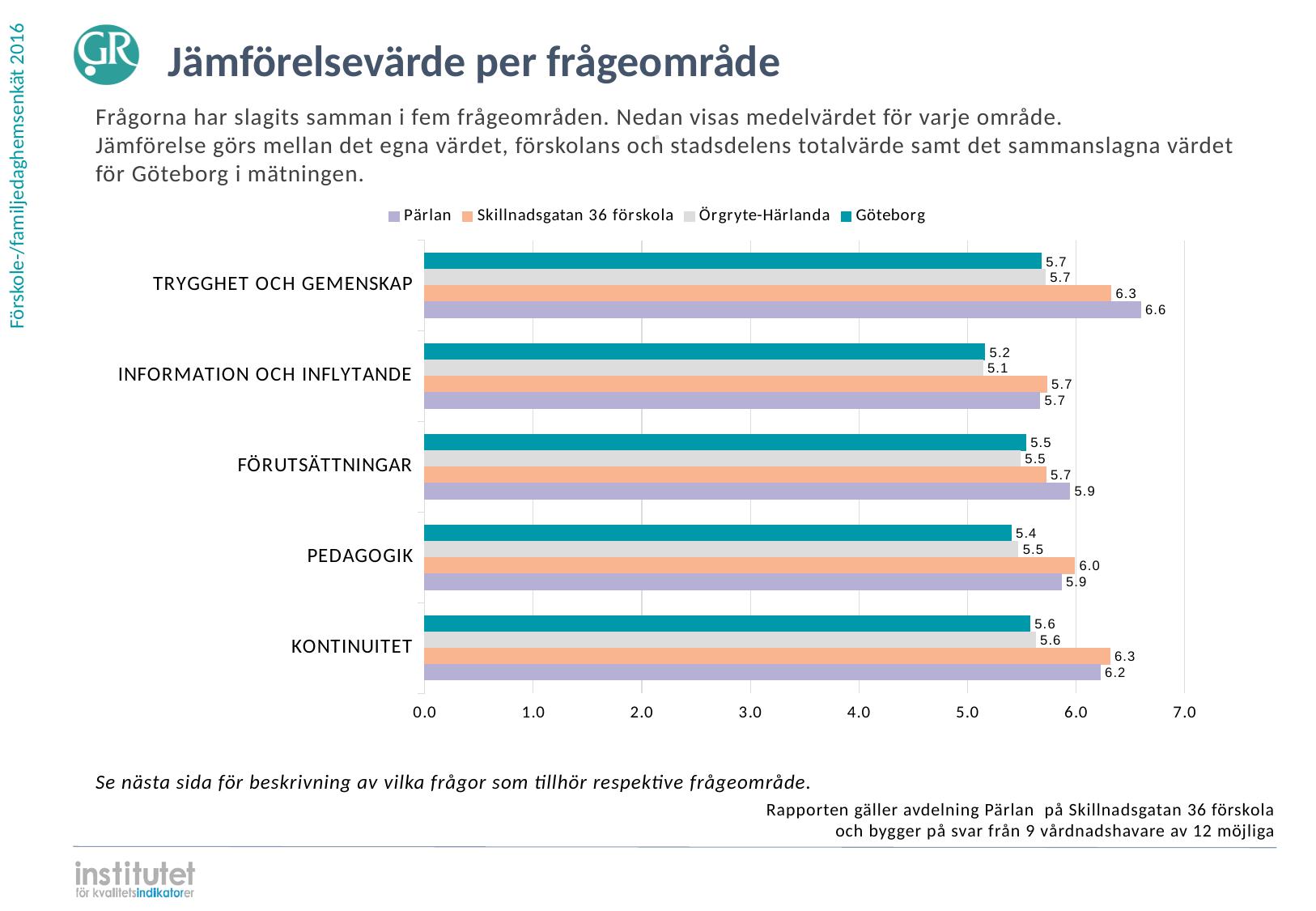
What is the value for Pärlan in TRYGGHET OCH GEMENSKAP? 6.6 What kind of chart is shown on the slide? bar chart What is the value for Skillnadsgatan 36 förskola in PEDAGOGIK? 6.0 What is the value for Göteborg in INFORMATION OCH INFLYTANDE? 5.2 What is the difference between Pärlan and Göteborg in TRYGGHET OCH GEMENSKAP? 0.9 In FÖRUTSÄTTNINGAR, which is larger: Pärlan or Skillnadsgatan 36 förskola? Pärlan In which category does Göteborg have its lowest value? INFORMATION OCH INFLYTANDE What is the value for Örgryte-Härlanda in KONTINUITET? 5.6 How many series does the legend list? 4 How many question areas (categories) are shown on the chart? 5 In which category does Pärlan have its highest value? TRYGGHET OCH GEMENSKAP Which series is shown in orange in the legend? Skillnadsgatan 36 förskola